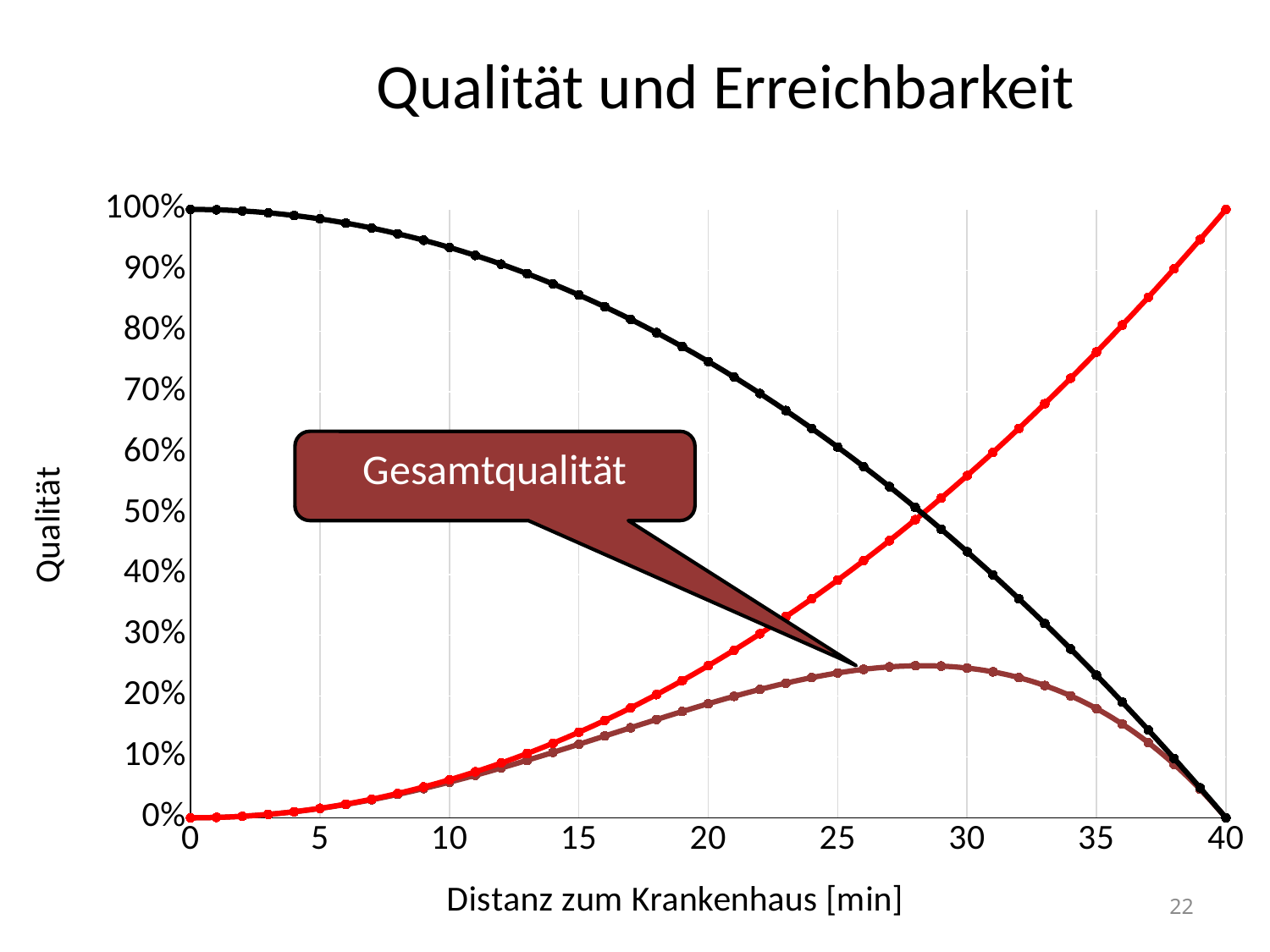
What is the title of the chart? Qualität und Erreichbarkeit Does the red line rise or fall as the distance increases? rise What is the value of the black line at 40 min? 0% What kind of chart is shown on the slide? line chart How many lines are plotted on the chart? 3 Is the value of the black line at 20 min greater or less than 70%? greater Is the highest value of the Gesamtqualität line greater or less than 30%? less What is the label of the x axis? Distanz zum Krankenhaus [min] What is the value of the black line at 0 min? 100% At 35 min, which line has the larger value, the red line or the black line? red line What is the value of the red line at 40 min? 100% Does the black line rise or fall as the distance increases? fall